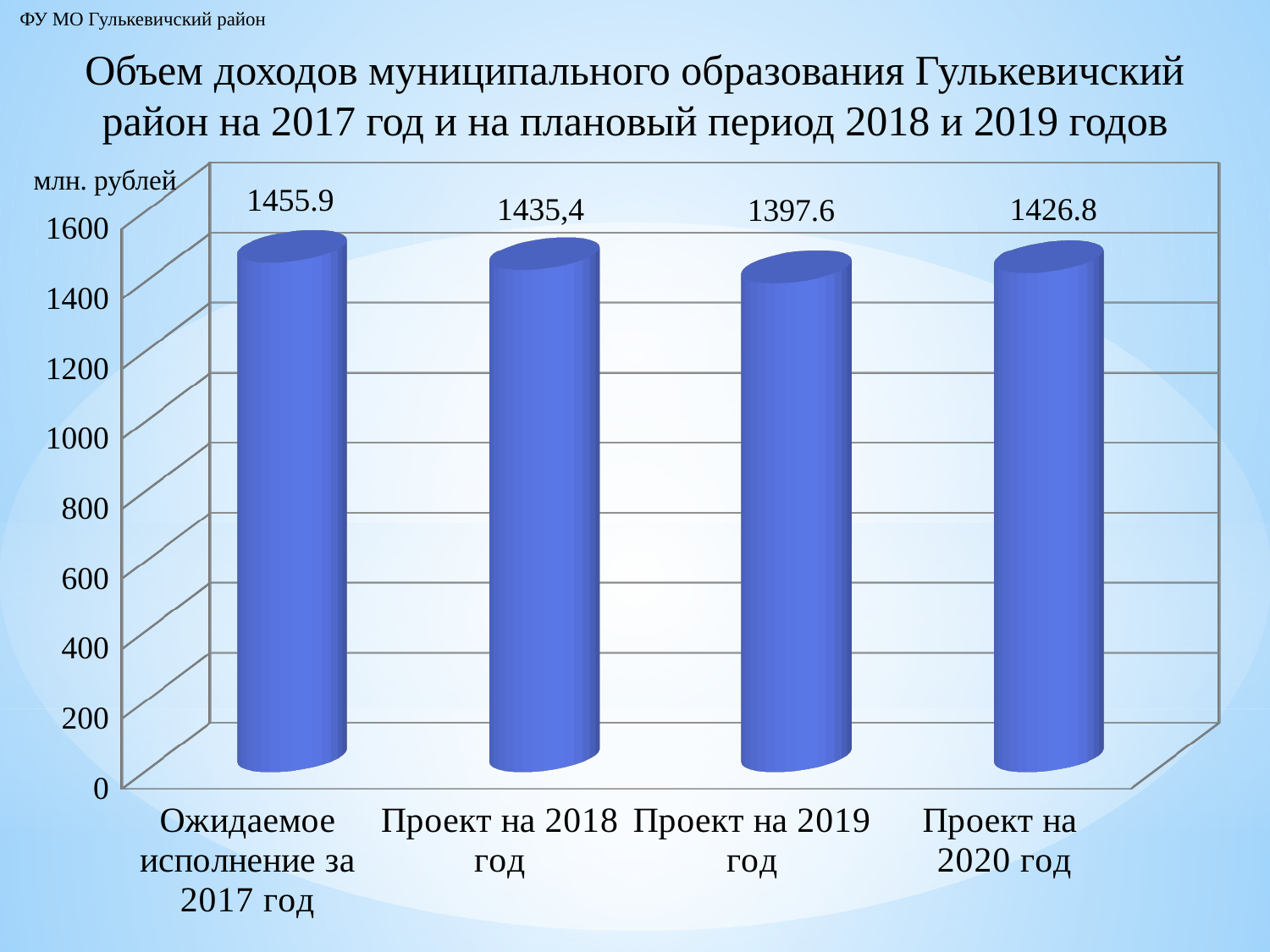
How many categories are shown on the chart? 4 Which category has the highest value? Ожидаемое исполнение за 2017 год Which category has the lowest value? Проект на 2019 год What is the value for "Проект на 2020 год"? 1426.8 What is the difference between the values for "Проект на 2020 год" and "Проект на 2019 год"? 29.2 What is the difference between the values for "Ожидаемое исполнение за 2017 год" and "Проект на 2019 год"? 58.3 What is the value for "Ожидаемое исполнение за 2017 год"? 1455.9 What is the value for "Проект на 2019 год"? 1397.6 What unit of measurement is indicated on the chart? млн. рублей What is the value for "Проект на 2018 год"? 1435,4 What kind of chart is shown on the slide? Bar chart Which is larger, the value for "Проект на 2018 год" or the value for "Проект на 2020 год"? Проект на 2018 год